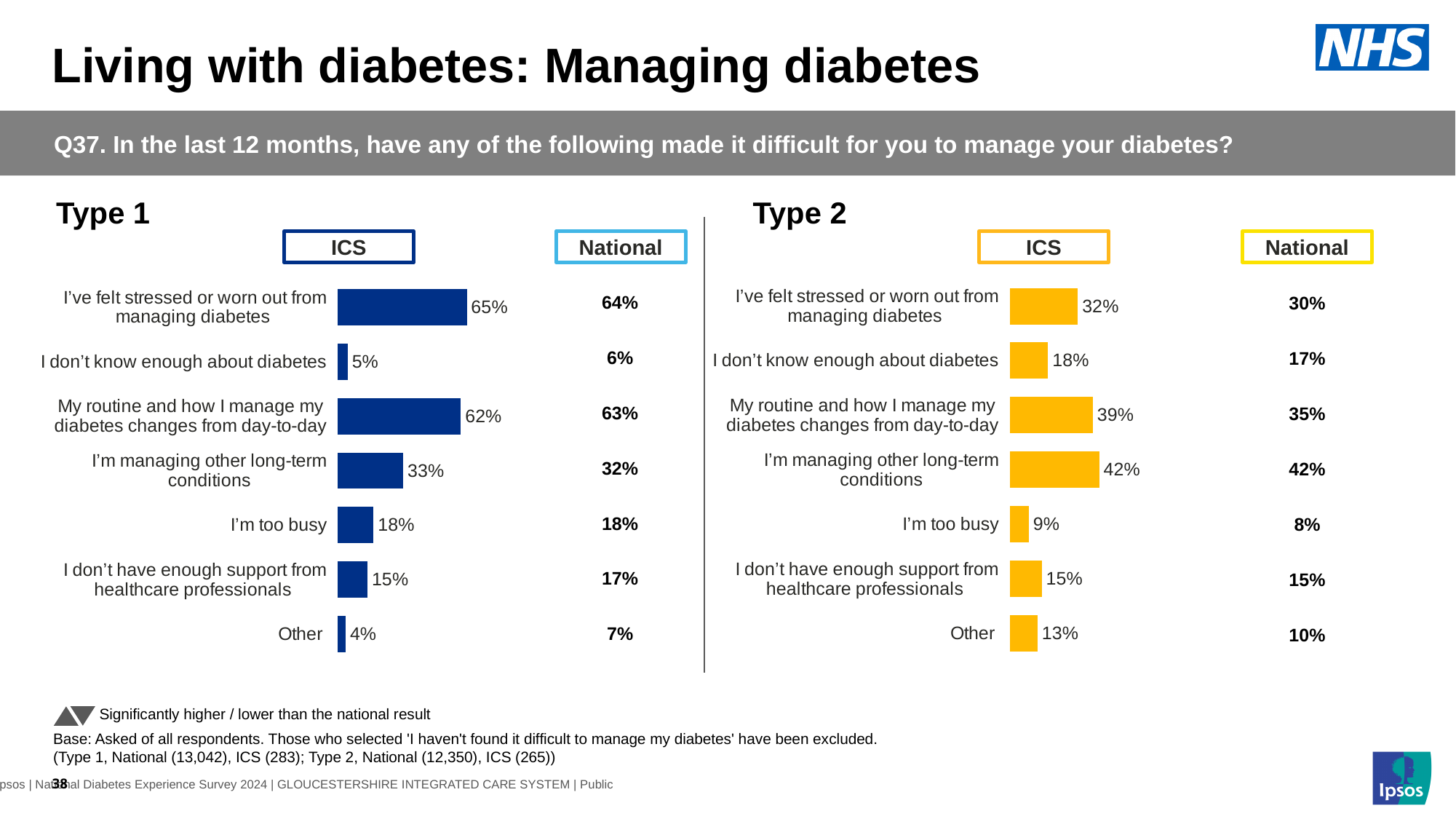
In the Type 1 chart, what is the difference between the ICS values for 'I've felt stressed or worn out from managing diabetes' and 'I'm too busy'? 47% In the Type 1 chart, which is larger for 'I'm managing other long-term conditions': the ICS value or the National value? ICS In the Type 2 chart, what is the ICS value for 'My routine and how I manage my diabetes changes from day-to-day'? 39% In the Type 2 chart, which category has the highest ICS value? I'm managing other long-term conditions In the Type 2 chart, is the ICS value for 'I'm too busy' greater or less than the National value? greater What kind of chart is used for the Type 2 ICS results? bar chart In the Type 2 chart, what is the difference between the ICS and National values for 'Other'? 3% What colour are the ICS bars in the Type 2 chart? Yellow In the Type 1 chart, what is the National value for 'Other'? 7% How many categories are shown in the Type 1 chart? 7 In the Type 1 chart, what is the ICS value for 'I've felt stressed or worn out from managing diabetes'? 65% In the Type 1 chart, which category has the lowest ICS value? Other